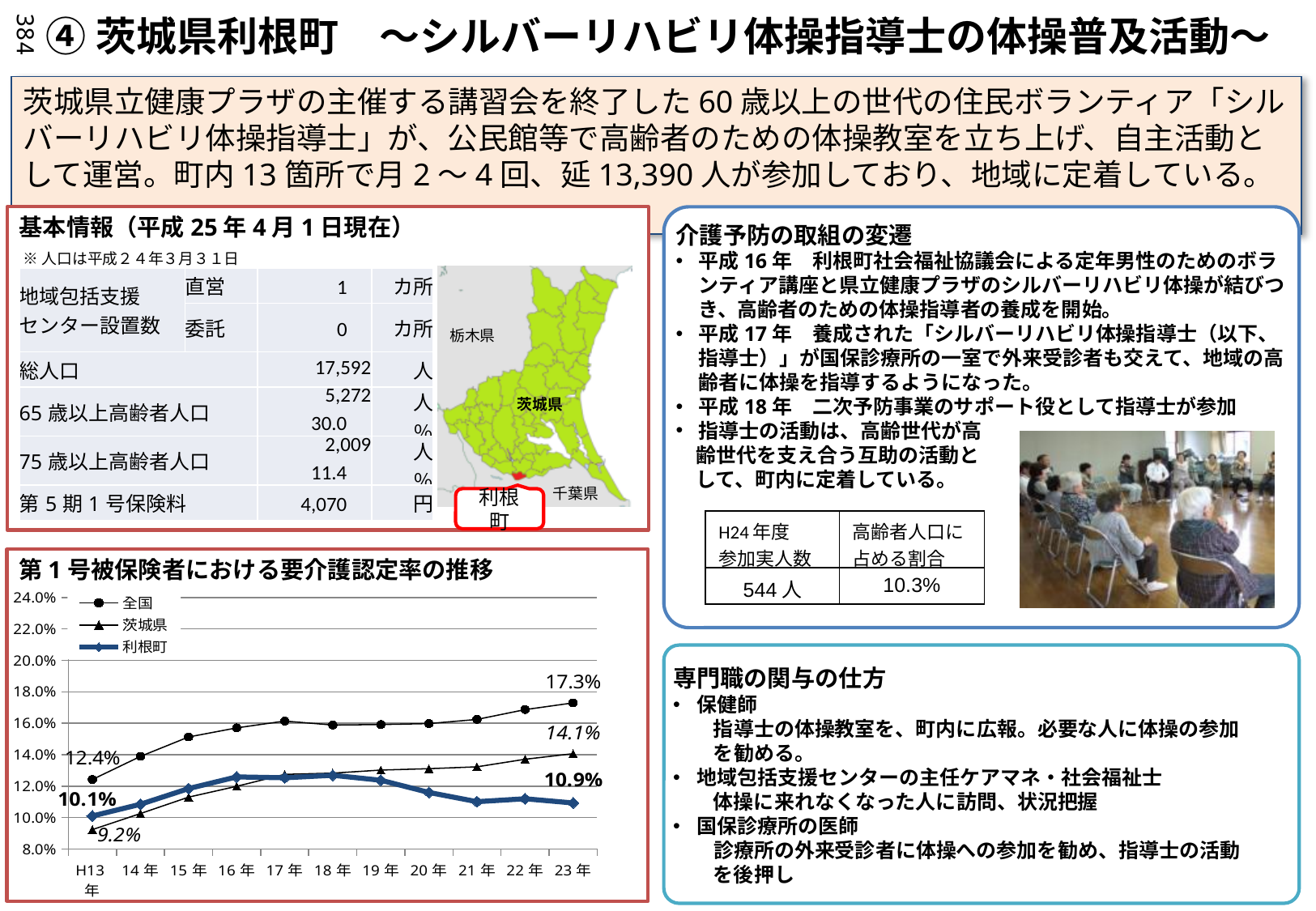
What are the three series named in the legend of the 要介護認定率の推移 chart? 全国, 茨城県, 利根町 In the 要介護認定率の推移 chart, what is the value for 利根町 in 23年? 10.9% How many years (points) are shown along the x axis of the 要介護認定率の推移 chart? 11 How many series does the legend of the 要介護認定率の推移 chart list? 3 In the 要介護認定率の推移 chart, what is the difference between the 全国 and 利根町 values in 23年? 6.4% In the 要介護認定率の推移 chart, what is the value for 茨城県 in H13年? 9.2% In the 要介護認定率の推移 chart, what is the value for 茨城県 in 23年? 14.1% In the 要介護認定率の推移 chart, which series has the highest value in 23年? 全国 In the 要介護認定率の推移 chart, does the 全国 series rise or fall from H13年 to 23年? rise What type of chart is shown under the title 第1号被保険者における要介護認定率の推移? line chart In the 要介護認定率の推移 chart, what is the value for 全国 in H13年? 12.4% In the 要介護認定率の推移 chart, what is the value for 全国 in 23年? 17.3%